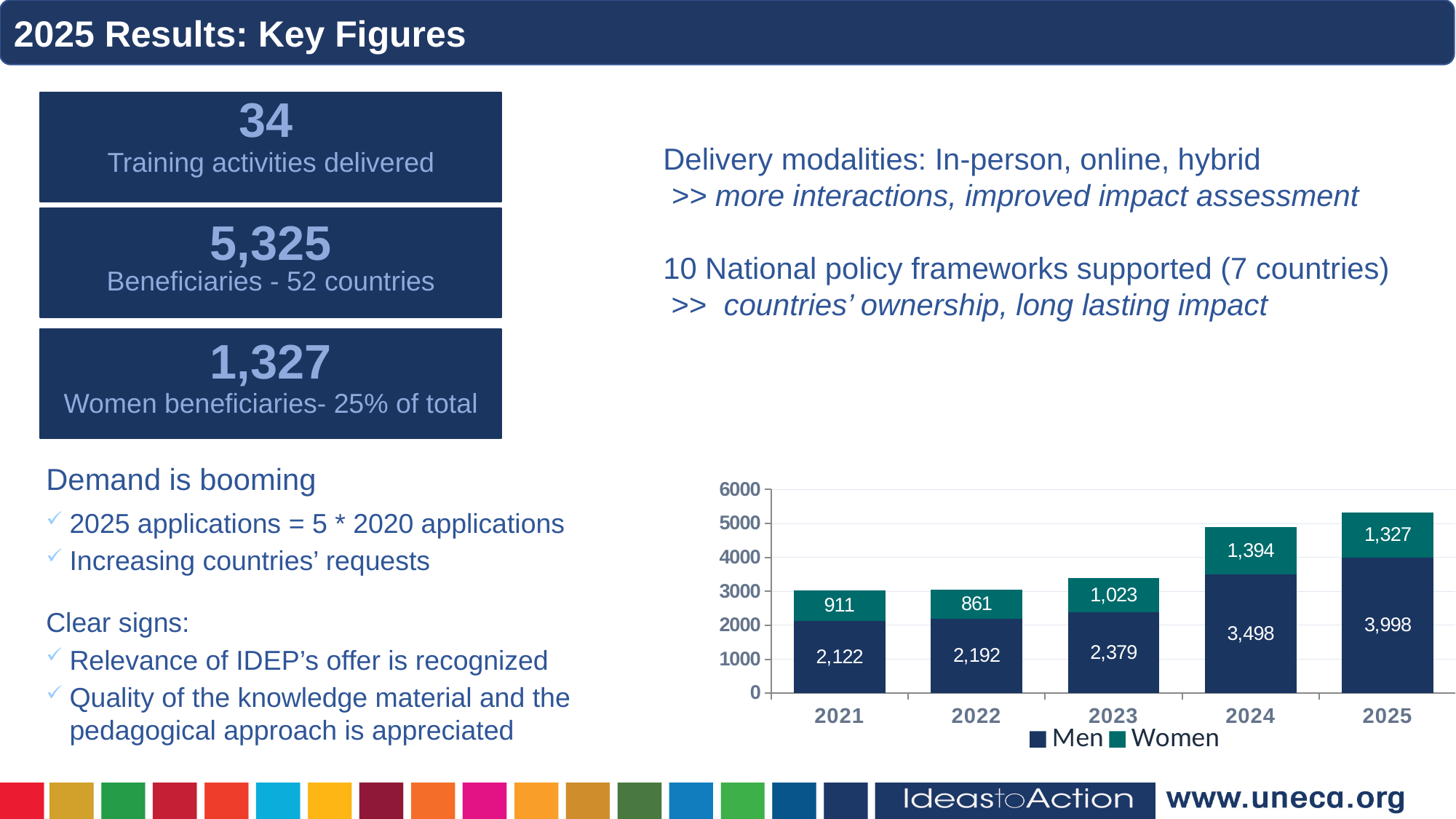
Which is larger, the Women value for 2024 or for 2025? 2024 Does the value for Men rise or fall from 2021 to 2025? Rise What is the value for Women in 2024? 1,394 What is the value for Women in 2021? 911 What is the difference between the Men values for 2025 and 2024? 500 What type of chart is shown on the slide? Stacked bar chart What is the value for Men in 2023? 2,379 What is the total of the stacked bar for 2025? 5,325 In which year is the value for Men the highest? 2025 How many years are shown on the x axis of the chart? 5 How many series does the chart legend list? 2 In which year is the value for Women the lowest? 2022